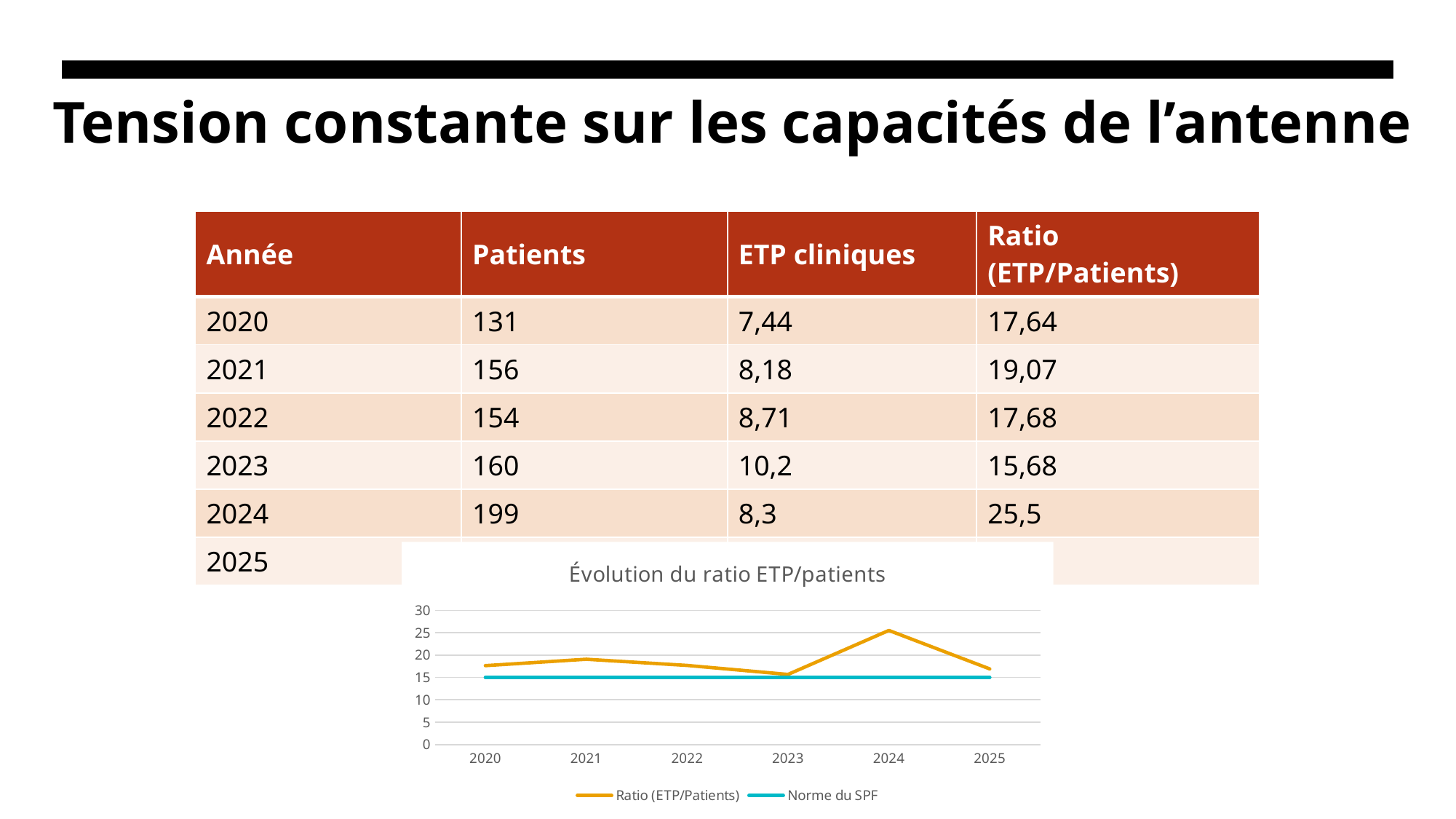
What is the value of the Ratio (ETP/Patients) for 2024? 25,5 In which year does the Ratio (ETP/Patients) line reach its highest value? 2024 What is the value of the Ratio (ETP/Patients) for 2023? 15,68 How many series does the chart legend list? 2 What is the title of the chart? Évolution du ratio ETP/patients Is the Ratio (ETP/Patients) value for 2025 greater or less than 20? less How many years are plotted along the x axis of the chart? 6 What kind of chart is shown on the slide? line chart In which year does the Ratio (ETP/Patients) line reach its lowest value? 2023 Which year has the larger Ratio (ETP/Patients), 2021 or 2022? 2021 Does the Ratio (ETP/Patients) line rise or fall from 2023 to 2024? rise What is the difference between the Ratio (ETP/Patients) in 2024 and in 2023? 9,82